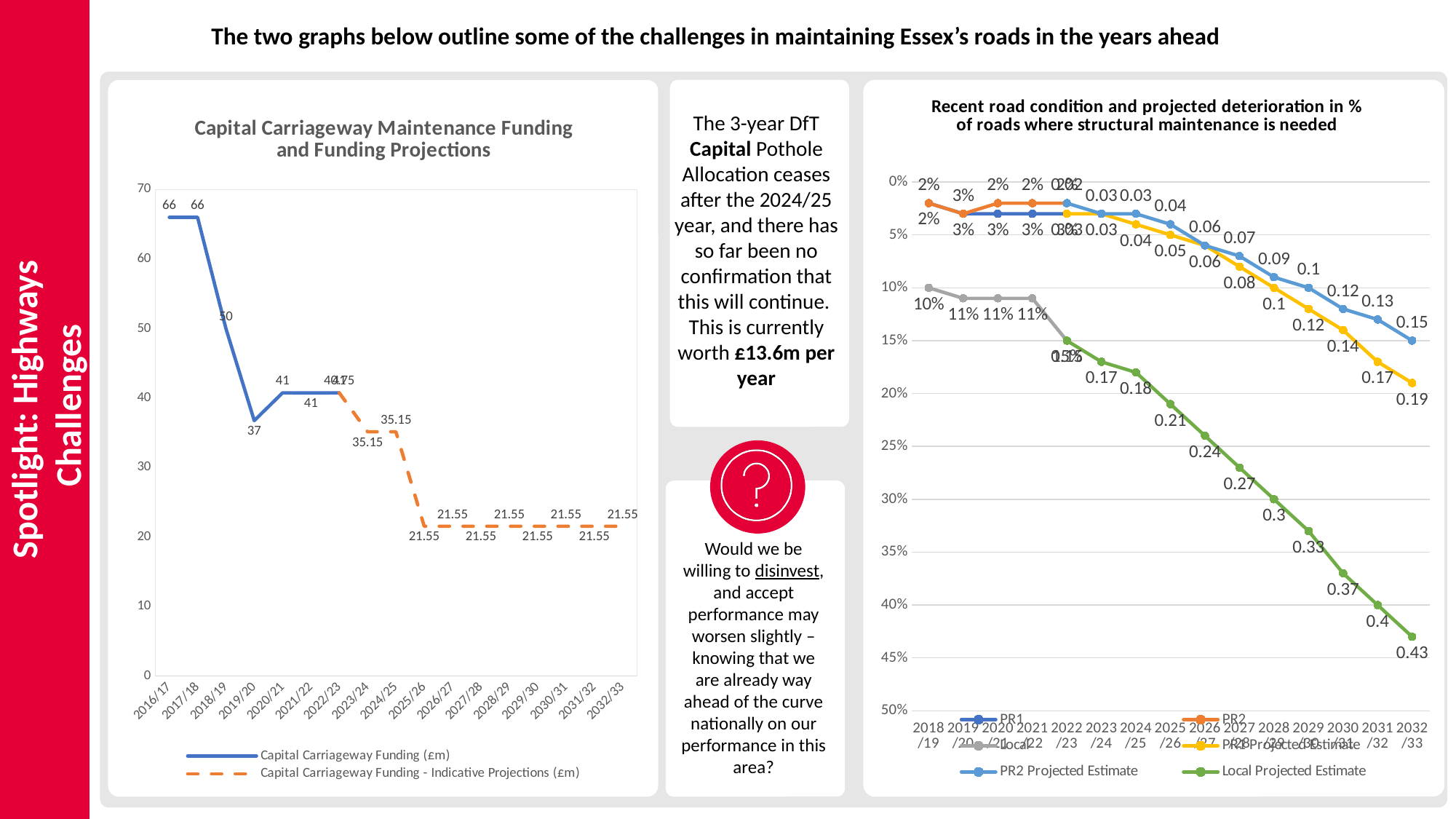
In the chart titled 'Capital Carriageway Maintenance Funding and Funding Projections', what is the difference between the 2017/18 value and the 2018/19 value? 16 In the chart titled 'Capital Carriageway Maintenance Funding and Funding Projections', what is the value for 2019/20? 37 In the chart titled 'Recent road condition and projected deterioration', how many series does the legend list? 6 In the chart titled 'Recent road condition and projected deterioration', what is the Local Projected Estimate value for 2032/33? 0.43 In the chart titled 'Capital Carriageway Maintenance Funding and Funding Projections', which year has the lowest value? 2025/26 to 2032/33 (21.55) In the chart titled 'Capital Carriageway Maintenance Funding and Funding Projections', what is the value for 2016/17? 66 In the chart titled 'Capital Carriageway Maintenance Funding and Funding Projections', how many series does the legend list? 2 In the chart titled 'Recent road condition and projected deterioration', which series has the highest value in 2032/33? Local Projected Estimate In the chart titled 'Recent road condition and projected deterioration', what is the Local value for 2018/19? 10% What kind of chart is the 'Capital Carriageway Maintenance Funding and Funding Projections' chart? line chart In the chart titled 'Capital Carriageway Maintenance Funding and Funding Projections', do the values generally rise or fall from 2016/17 to 2032/33? fall In the chart titled 'Capital Carriageway Maintenance Funding and Funding Projections', what is the indicative projection value for 2032/33? 21.55